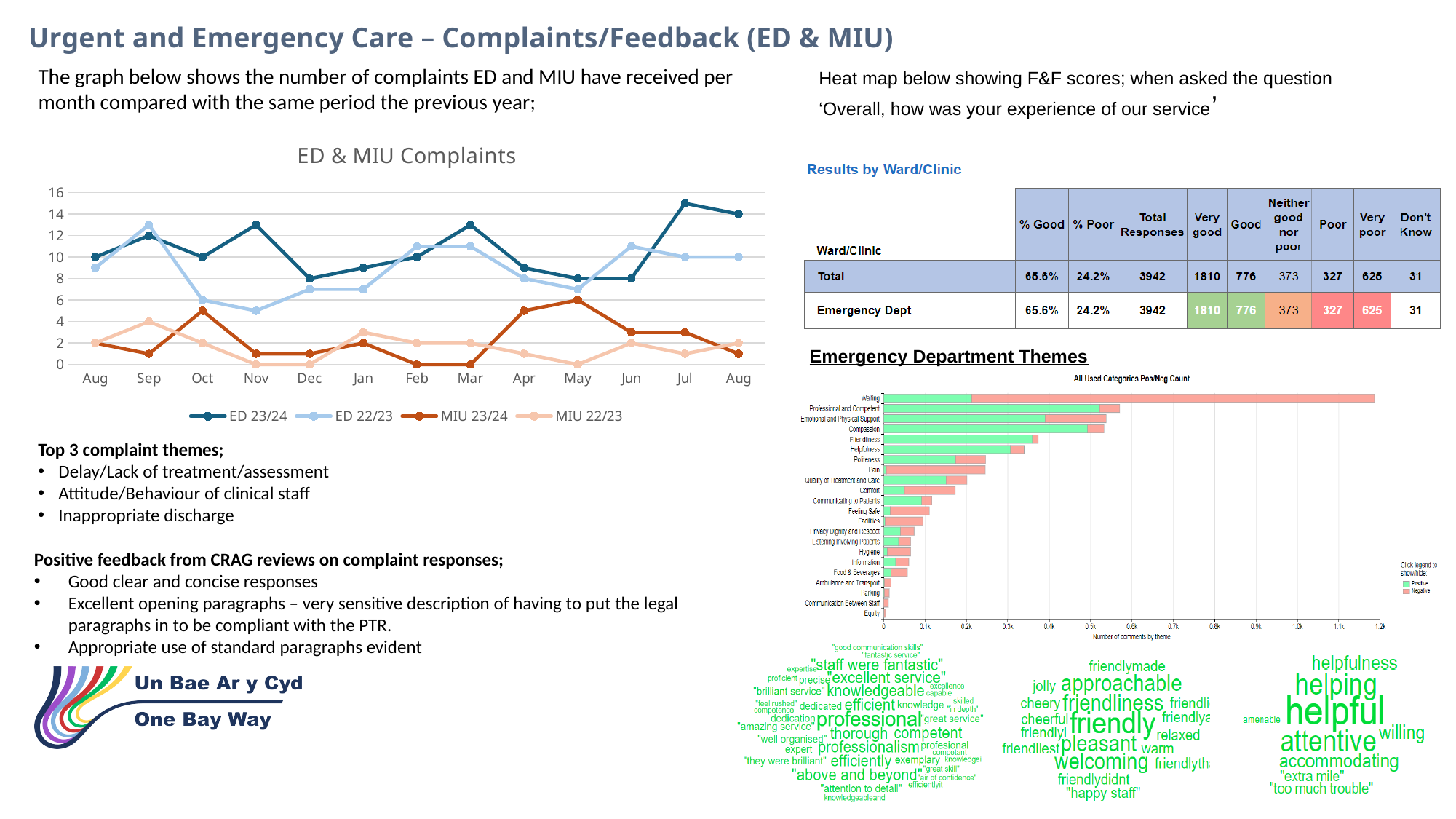
In the 'ED & MIU Complaints' chart, what is the difference between ED 23/24 in Sep and ED 23/24 in Dec? 4 In the 'All Used Categories Pos/Neg Count' chart, which category has the longest bar? Waiting In the 'ED & MIU Complaints' chart, which is larger in Nov: ED 23/24 or ED 22/23? ED 23/24 In the 'ED & MIU Complaints' chart, in which month does ED 23/24 reach its highest value? Jul In the 'ED & MIU Complaints' chart, what is the value for ED 23/24 in Sep? 12 In the 'ED & MIU Complaints' chart, what is the value for ED 22/23 in Oct? 6 What type of chart is the 'All Used Categories Pos/Neg Count' chart under Emergency Department Themes? Bar chart How many series does the legend of the 'ED & MIU Complaints' chart list? 4 In the 'ED & MIU Complaints' chart, what is the value for MIU 23/24 in May? 6 In the 'ED & MIU Complaints' chart, is the value for ED 23/24 in Jul greater or less than 12? greater What type of chart is the 'ED & MIU Complaints' chart? Line chart How many months are shown on the x axis of the 'ED & MIU Complaints' chart? 13